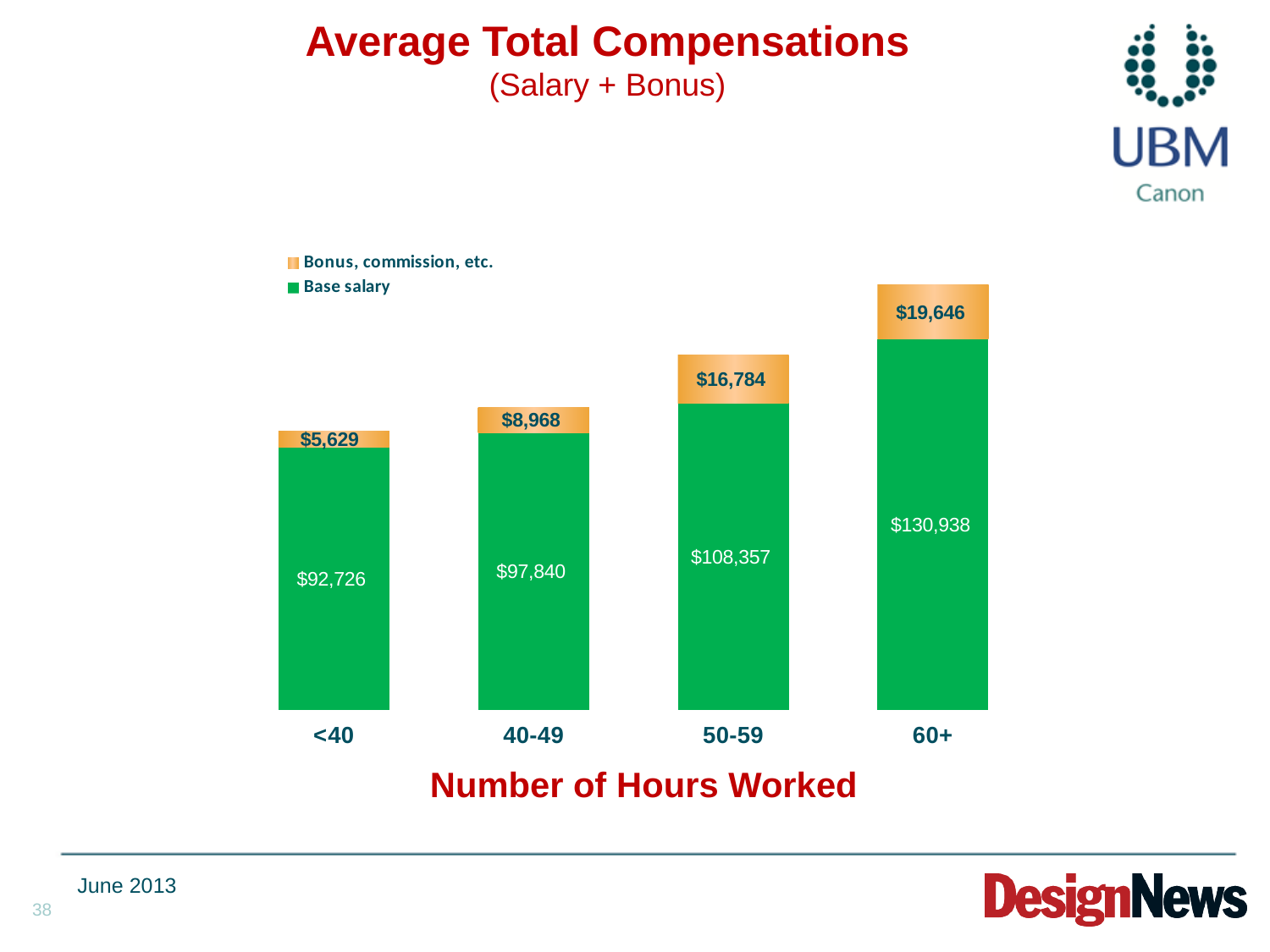
Which hours-worked category has the lowest bonus, commission, etc. value? <40 Which hours-worked category has the highest base salary? 60+ What is the total compensation (base salary plus bonus) for the <40 category? $98,355 How many series does the legend list? 2 Which is larger, the base salary for 40-49 hours or for 50-59 hours? 50-59 What is the bonus, commission, etc. value for the 50-59 hours category? $16,784 What is the base salary for the <40 hours category? $92,726 How many hours-worked categories are shown on the x axis? 4 What is the difference in base salary between the 60+ and <40 categories? $38,212 What is the difference in bonus, commission, etc. between the 60+ and 50-59 categories? $2,862 What is the base salary for the 60+ hours category? $130,938 What is the total compensation (base salary plus bonus) for the 60+ category? $150,584